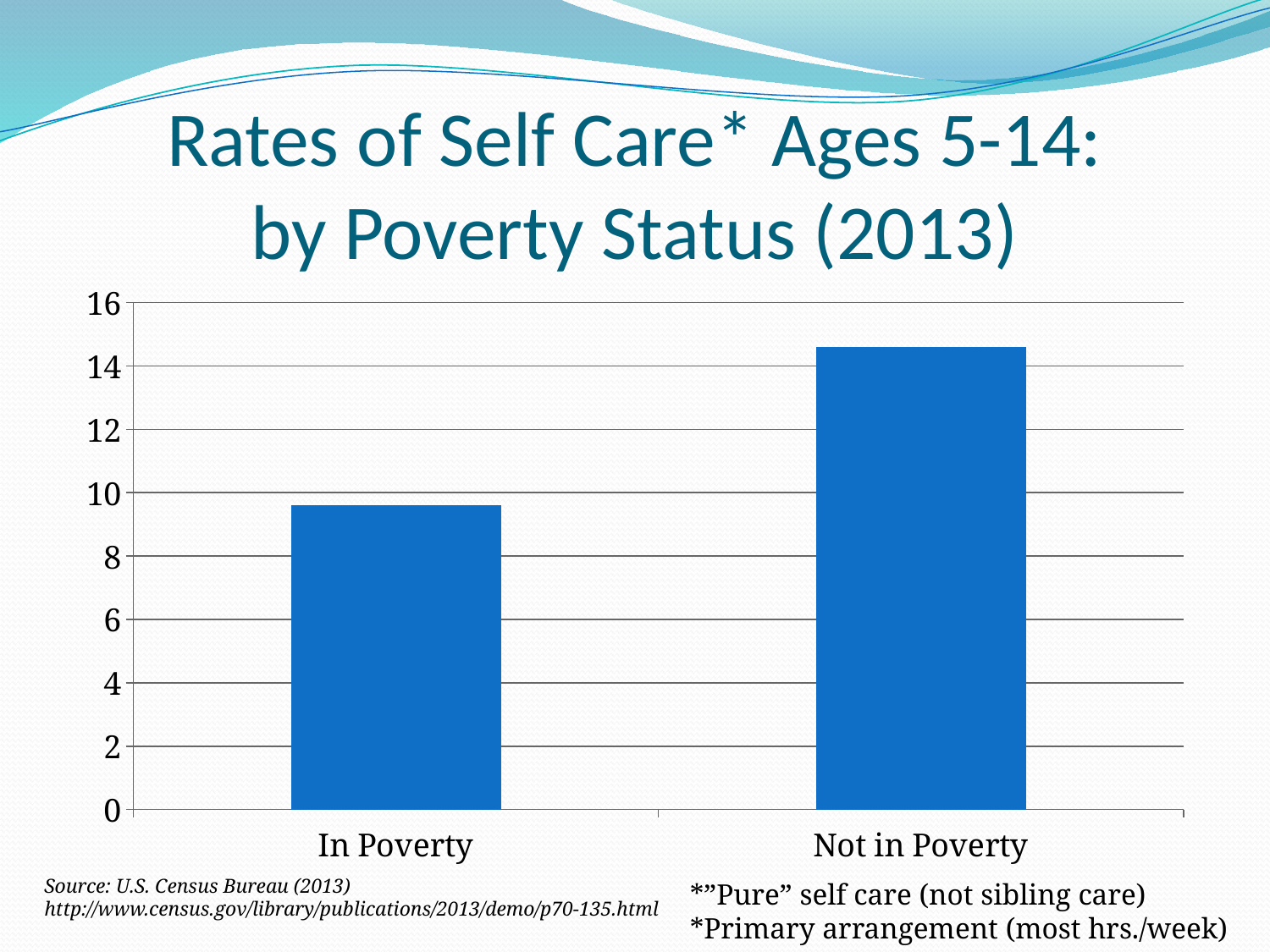
What is the highest value shown on the vertical axis? 16 Is the bar for Not in Poverty taller or shorter than the bar for In Poverty? taller Which category has the lower rate of self care? In Poverty Is the value for Not in Poverty greater or less than 16? less What kind of chart is shown on the slide? bar chart Which category has the higher rate of self care? Not in Poverty How many categories are plotted in the chart? 2 What is the title of the chart on the slide? Rates of Self Care* Ages 5-14: by Poverty Status (2013) Is the value for In Poverty greater or less than 8? greater Is the value for Not in Poverty greater or less than 14? greater